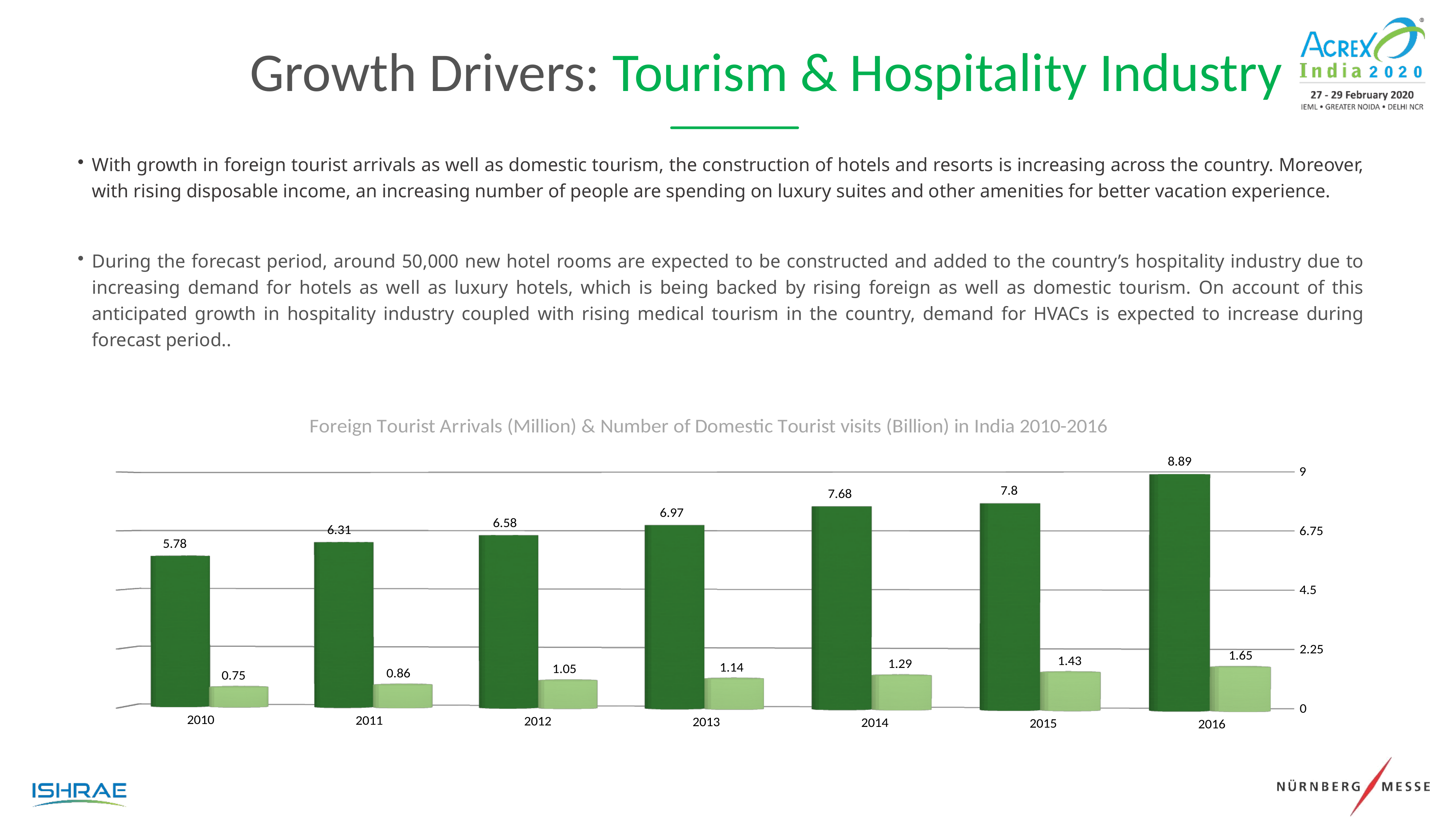
What is the difference between the dark green bar values for 2016 and 2010? 3.11 In which year is the light green bar lowest? 2010 What is the value of the light green bar for 2015? 1.43 In which year is the dark green bar highest? 2016 What kind of chart is shown on the slide? bar chart Which year has the larger dark green bar value, 2014 or 2015? 2015 What is the value of the dark green bar for 2010? 5.78 What is the difference between the light green bar values for 2016 and 2010? 0.9 How many years are shown on the x axis of the chart? 7 Do the light green bar values rise or fall from 2010 to 2016? rise Is the value of the dark green bar for 2012 greater or less than 6.75? less What is the value of the dark green bar for 2013? 6.97